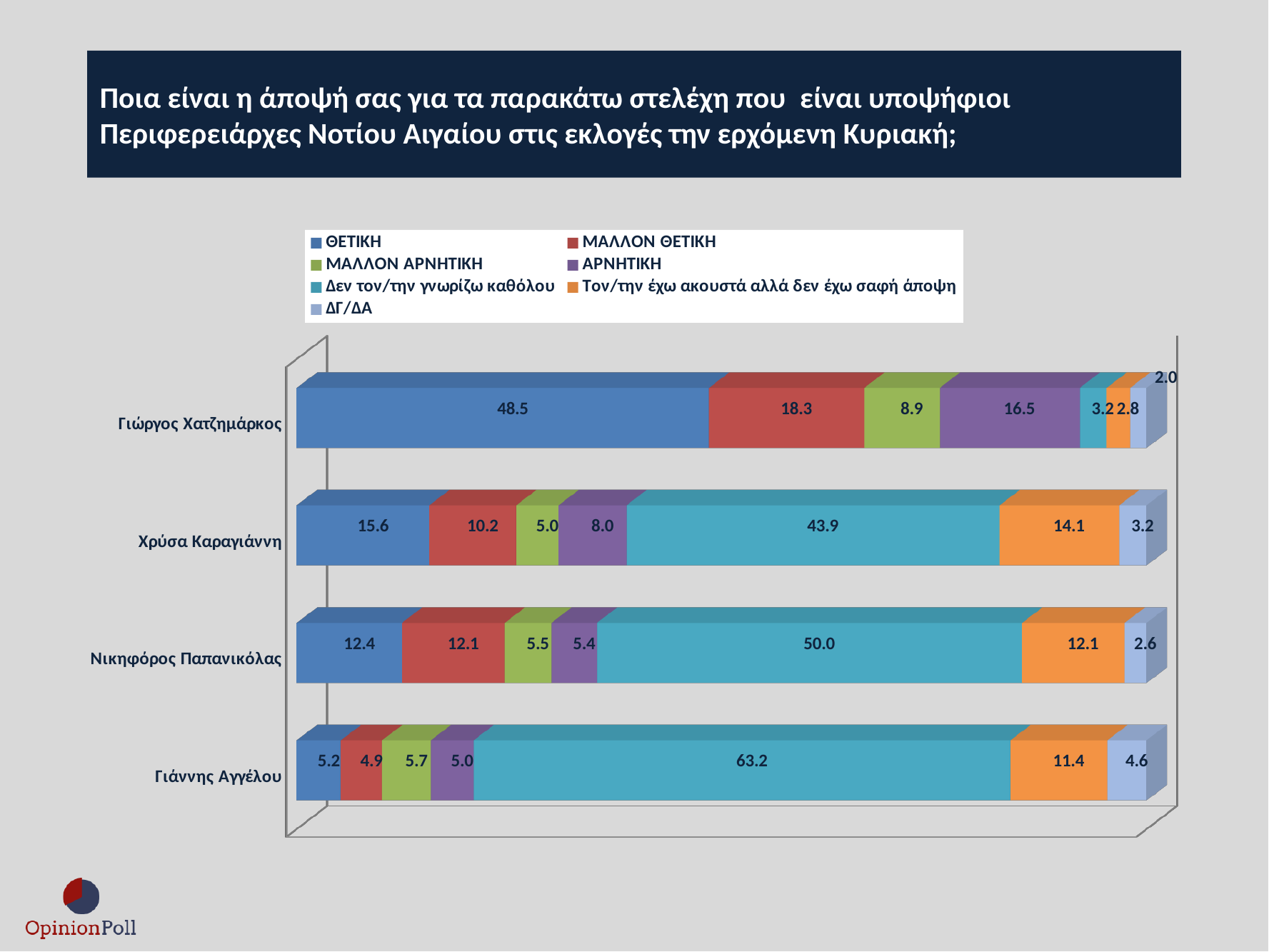
Which candidate has the highest value for 'Δεν τον/την γνωρίζω καθόλου'? Γιάννης Αγγέλου What is the ΘΕΤΙΚΗ value for Γιώργος Χατζημάρκος? 48.5 How many series does the legend list? 7 How many candidates are shown in the chart? 4 What is the difference between the ΘΕΤΙΚΗ values of Γιώργος Χατζημάρκος and Χρύσα Καραγιάννη? 32.9 Which candidate has the highest ΘΕΤΙΚΗ value? Γιώργος Χατζημάρκος What is the value of 'Δεν τον/την γνωρίζω καθόλου' for Γιάννης Αγγέλου? 63.2 Which candidate has the lowest ΘΕΤΙΚΗ value? Γιάννης Αγγέλου What is the value of 'Τον/την έχω ακουστά αλλά δεν έχω σαφή άποψη' for Χρύσα Καραγιάννη? 14.1 Who has the larger ΑΡΝΗΤΙΚΗ value, Γιώργος Χατζημάρκος or Χρύσα Καραγιάννη? Γιώργος Χατζημάρκος What kind of chart is shown on the slide? Stacked bar chart What is the ΔΓ/ΔΑ value for Νικηφόρος Παπανικόλας? 2.6